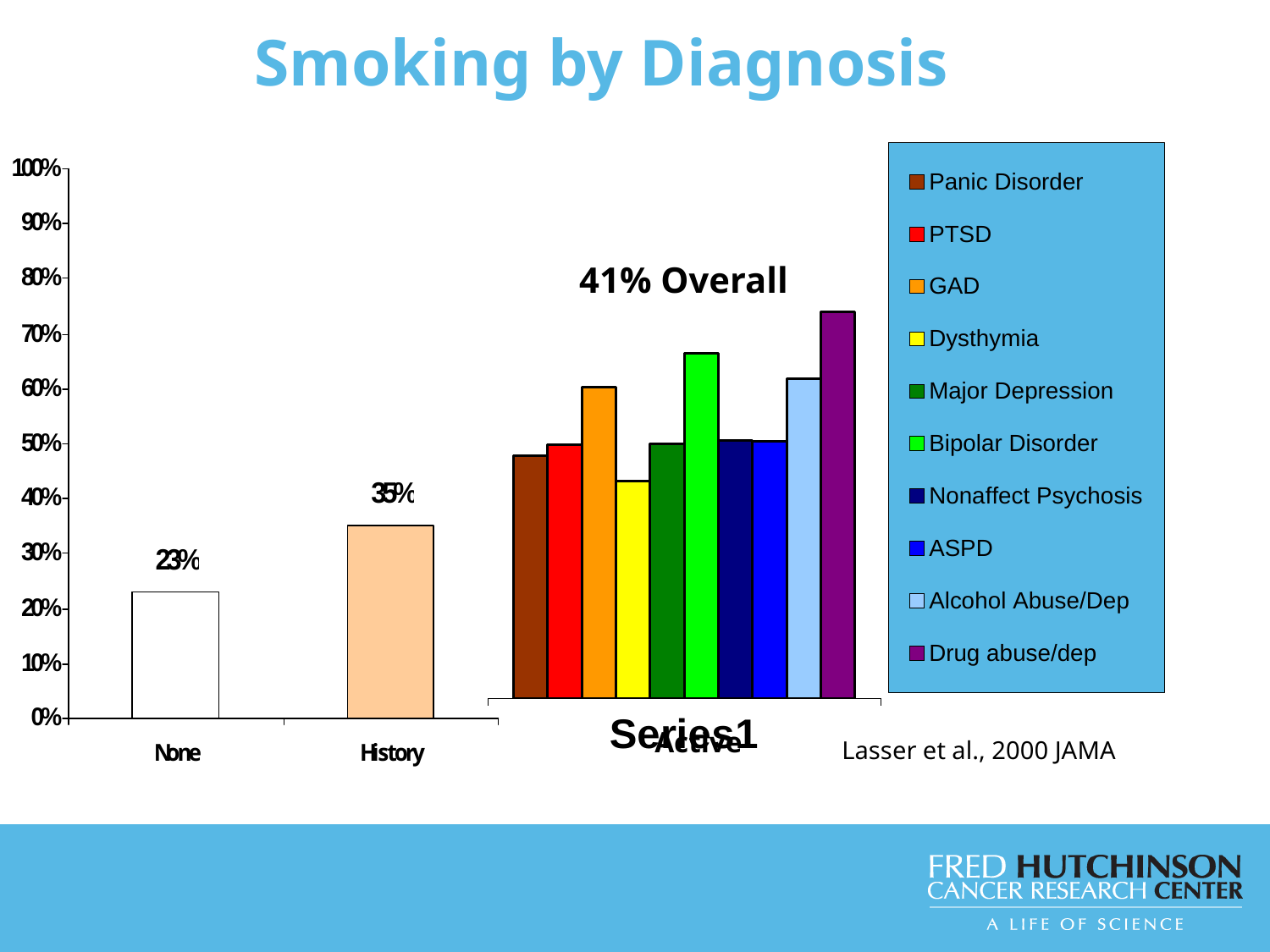
On the right chart, which diagnosis has the lowest value? Dysthymia On the right chart, which is larger, Bipolar Disorder or Major Depression? Bipolar Disorder On the left chart, which is larger, None or History? History On the left chart, how many categories are shown on the x axis? 2 On the left chart, what is the value for History? 35% On the left chart, what is the difference between the History and None values? 12% What kind of chart is the right chart (the one with the diagnosis legend)? Bar chart On the left chart, what is the value for None? 23% On the right chart, how many series does the legend list? 10 On the right chart, which diagnosis has the highest value? Drug abuse/dep